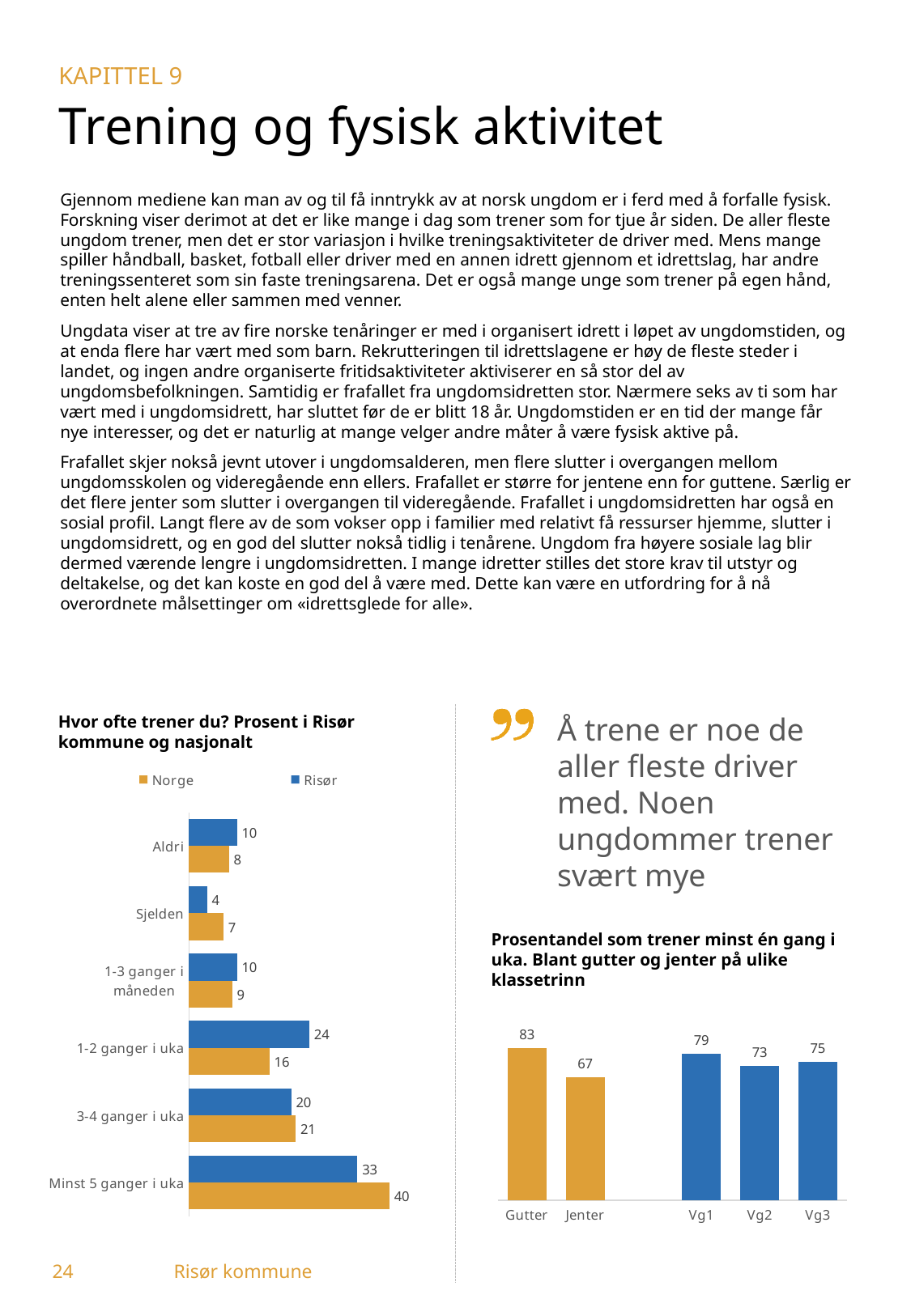
In the chart 'Prosentandel som trener minst én gang i uka', what is the value for Jenter? 67 In the chart 'Hvor ofte trener du? Prosent i Risør kommune og nasjonalt', what is the difference between Norge and Risør for 'Minst 5 ganger i uka'? 7 In the chart 'Prosentandel som trener minst én gang i uka', which category has the highest value? Gutter In the chart 'Hvor ofte trener du? Prosent i Risør kommune og nasjonalt', which category has the lowest value for Risør? Sjelden In the chart 'Hvor ofte trener du? Prosent i Risør kommune og nasjonalt', what is the value for Norge in the category '1-2 ganger i uka'? 16 In the chart 'Hvor ofte trener du? Prosent i Risør kommune og nasjonalt', which is larger for '1-2 ganger i uka': Norge or Risør? Risør In the chart 'Prosentandel som trener minst én gang i uka', what is the difference between Gutter and Jenter? 16 In the chart 'Hvor ofte trener du? Prosent i Risør kommune og nasjonalt', what is the value for Risør in the category 'Minst 5 ganger i uka'? 33 In the chart 'Hvor ofte trener du? Prosent i Risør kommune og nasjonalt', which category has the highest value for Norge? Minst 5 ganger i uka How many categories are shown in the chart 'Hvor ofte trener du? Prosent i Risør kommune og nasjonalt'? 6 How many series does the legend list in the chart 'Hvor ofte trener du? Prosent i Risør kommune og nasjonalt'? 2 What kind of chart is 'Prosentandel som trener minst én gang i uka'? Bar chart